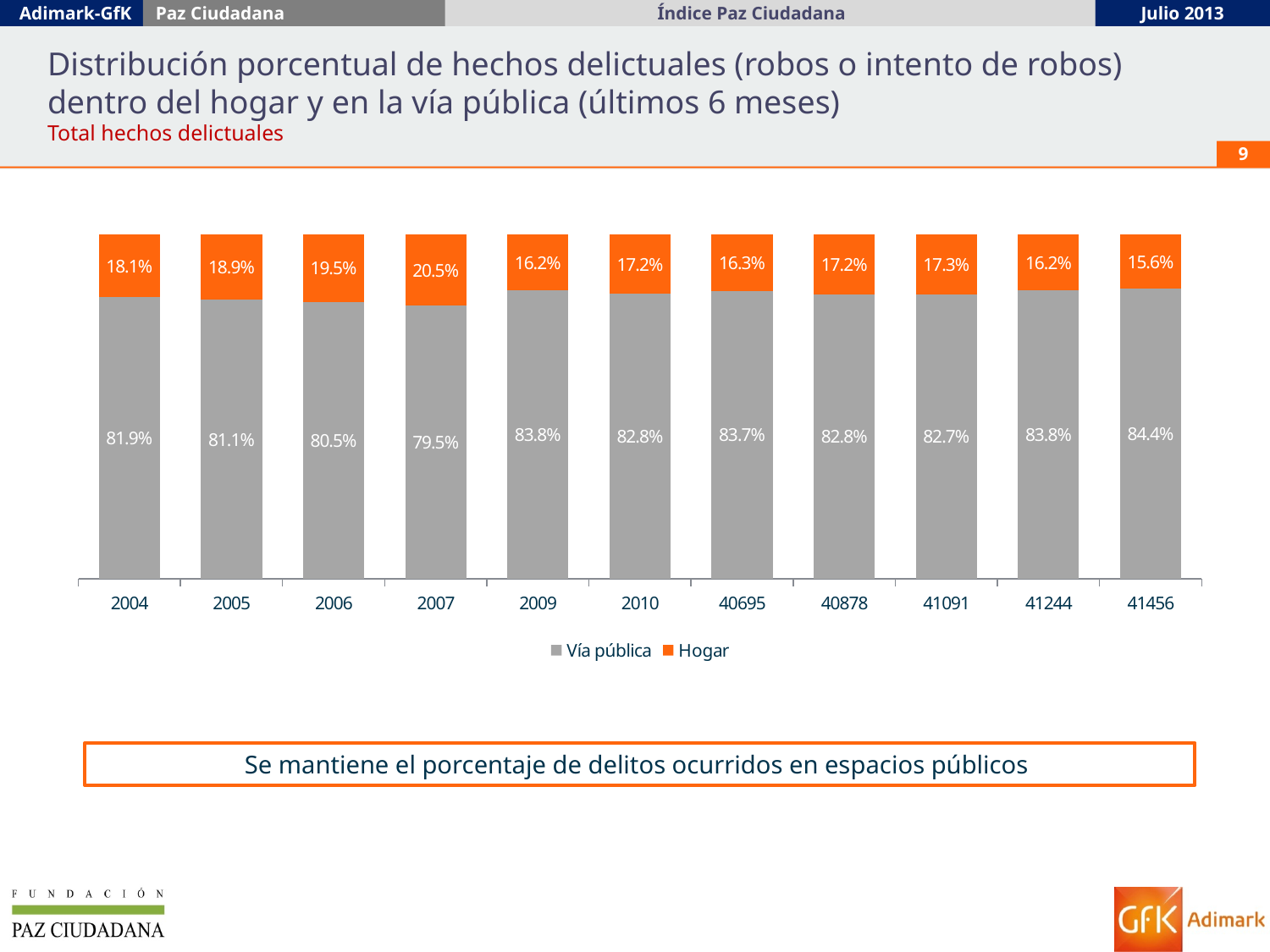
Which is larger, the Hogar value for 2006 or the Hogar value for 2010? 2006 What is the difference between the Vía pública value for 2009 and the Vía pública value for 2004? 1.9% What is the Hogar value for the category labelled 40695? 16.3% What is the Vía pública value for 2004? 81.9% What is the Vía pública value for the category labelled 41456? 84.4% What is the Hogar value for 2007? 20.5% Which category has the lowest Hogar value? 41456 How many categories are shown on the x axis? 11 How many series does the legend list? 2 What kind of chart is shown on the slide? Stacked bar chart Which category has the highest Hogar value? 2007 Which category has the lowest Vía pública value? 2007